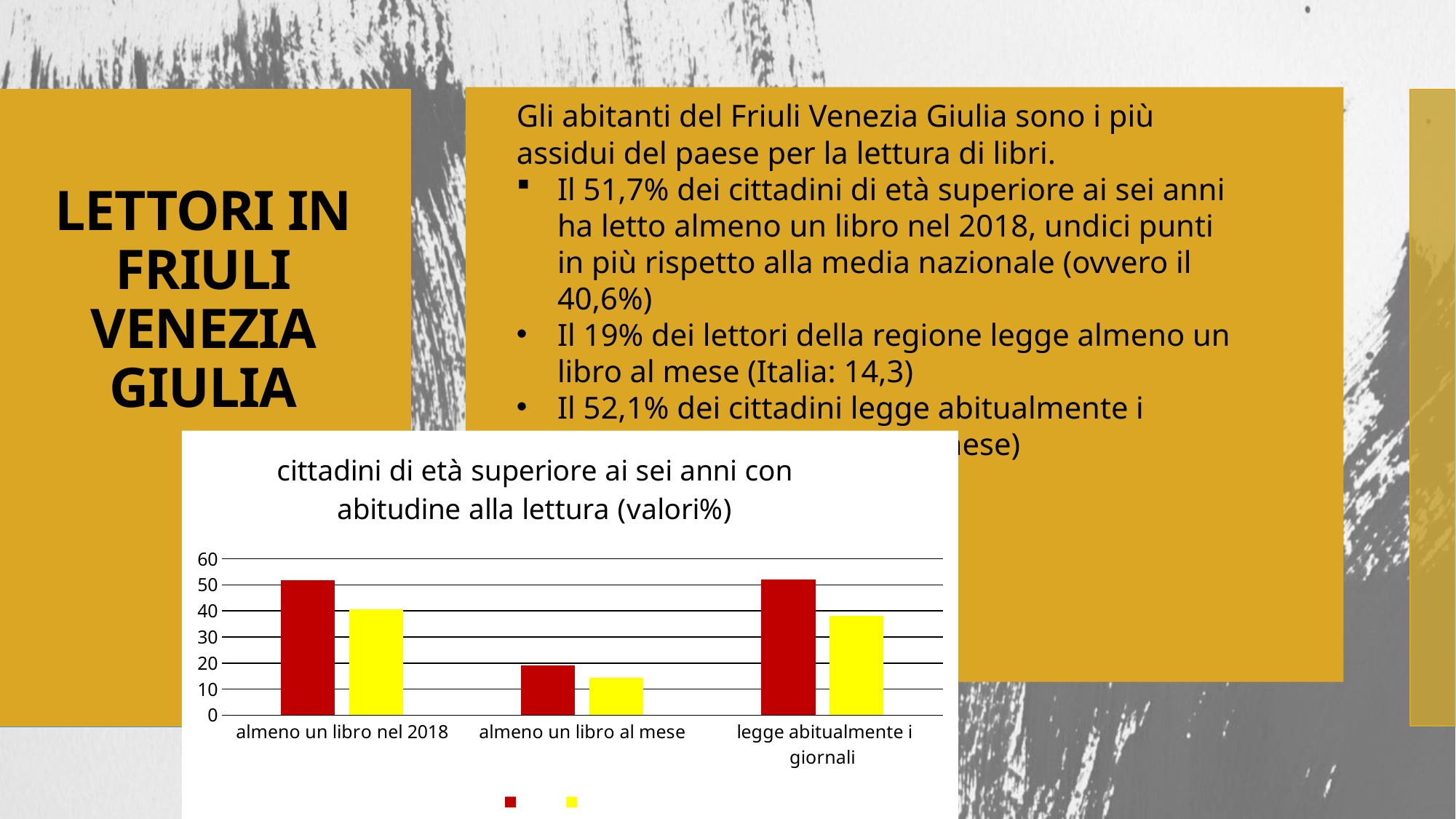
What is the title of the chart? cittadini di età superiore ai sei anni con abitudine alla lettura (valori%) Is the yellow bar for "almeno un libro al mese" greater or less than 20? less How many categories are shown on the x axis of the chart? 3 Is the red bar for "almeno un libro al mese" greater or less than 30? less Which is larger: the red bar for "almeno un libro al mese" or the red bar for "legge abitualmente i giornali"? legge abitualmente i giornali Is the yellow bar for "legge abitualmente i giornali" greater or less than 30? greater What colours are the two series in the chart? red and yellow What kind of chart is shown on the slide? bar chart Which category has the lowest red bar? almeno un libro al mese For "almeno un libro nel 2018", which bar is taller, the red one or the yellow one? the red one How many series does the chart's legend list? 2